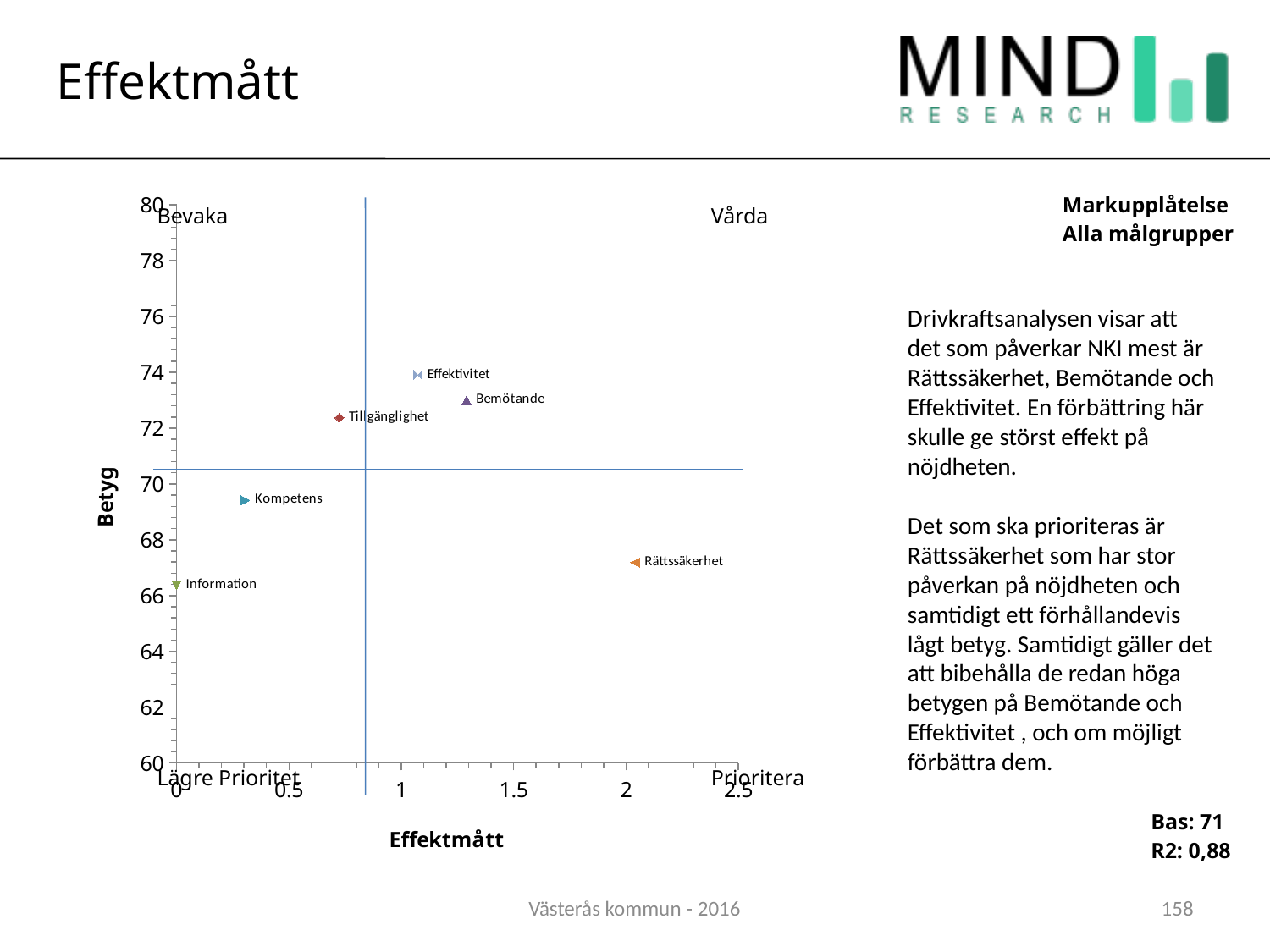
Is the Effektmått value for Rättssäkerhet greater or less than 1.5? greater Which point has the highest Betyg value? Effektivitet What is the title of the vertical axis of the chart? Betyg Which point has the highest Effektmått value? Rättssäkerhet Is the Betyg value for Rättssäkerhet greater or less than 68? less Which has a higher Betyg value, Tillgänglighet or Kompetens? Tillgänglighet Is the Betyg value for Kompetens greater or less than 70? less Which point has the lowest Effektmått value? Information What kind of chart is shown on the slide? scatter chart Which has a higher Effektmått value, Bemötande or Effektivitet? Bemötande Which point has the lowest Betyg value? Information How many data points are plotted in the chart? 6